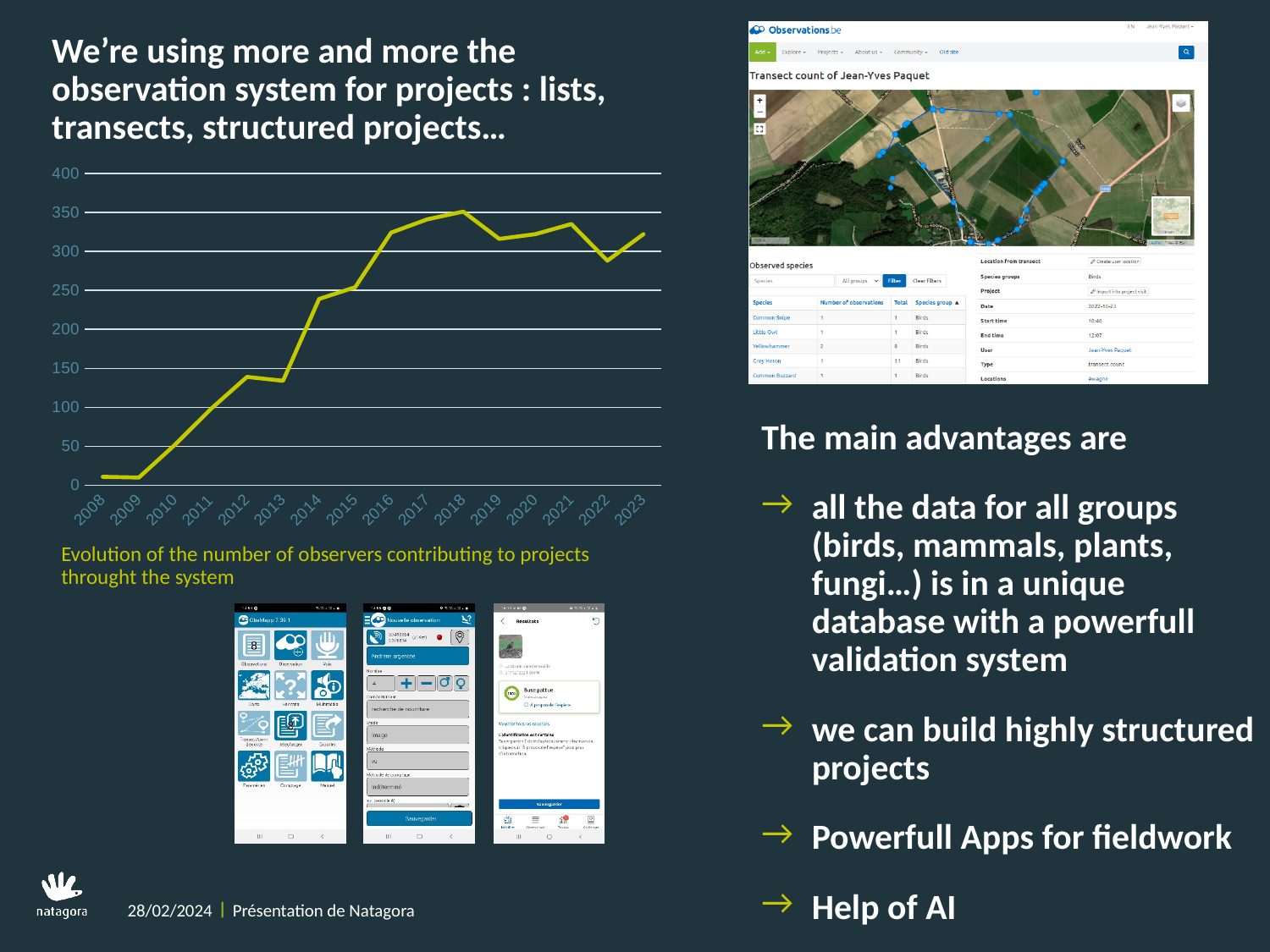
Which year has the larger value, 2013 or 2014? 2014 Is the value for 2016 greater or less than 300? greater Is the value for 2019 greater or less than 300? greater Is the value for 2013 greater or less than 200? less Which year has the larger value, 2021 or 2022? 2021 How many years are plotted along the x axis of the line chart? 16 What colour is the line in the chart? yellow Overall, does the number of observers rise or fall from 2008 to 2023? rise What kind of chart is shown on the left of the slide? line chart Which year has the highest number of observers in the line chart? 2018